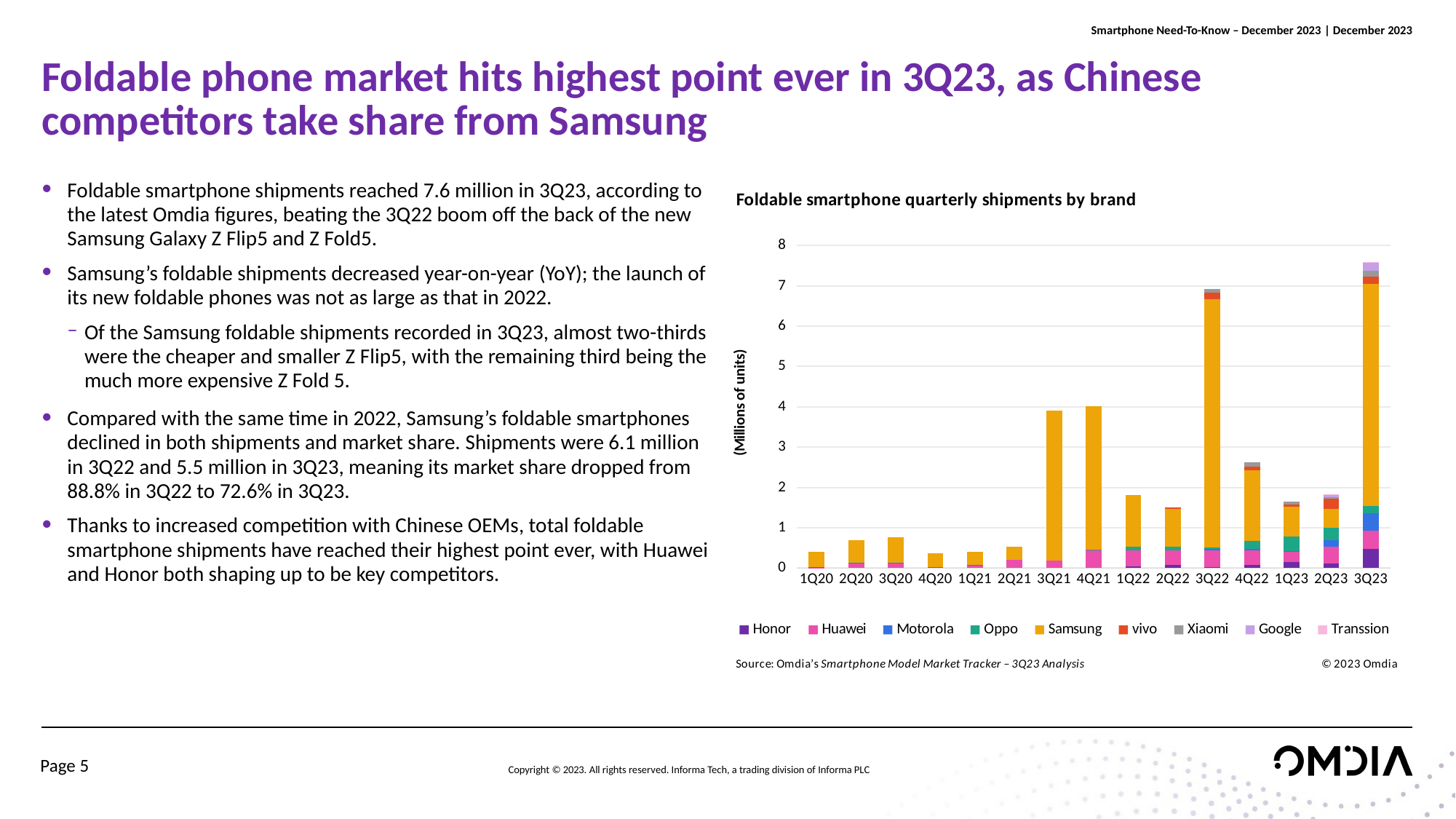
What is the label on the y axis of the chart? (Millions of units) How many brands does the chart legend list? 9 What kind of chart is shown on the slide? Stacked bar chart Do total foldable shipments rise or fall from 3Q22 to 1Q23? Fall Which quarter has the larger total shipments, 3Q22 or 4Q22? 3Q22 How many quarters are shown on the x axis of the chart? 15 Is the total shipment value for 3Q23 greater or less than 7 million units? greater Is the total shipment value for 1Q23 greater or less than 2 million units? less Is the total shipment value for 3Q22 greater or less than 6 million units? greater Which quarter has the highest total foldable smartphone shipments in the chart? 3Q23 What is the title of the chart? Foldable smartphone quarterly shipments by brand